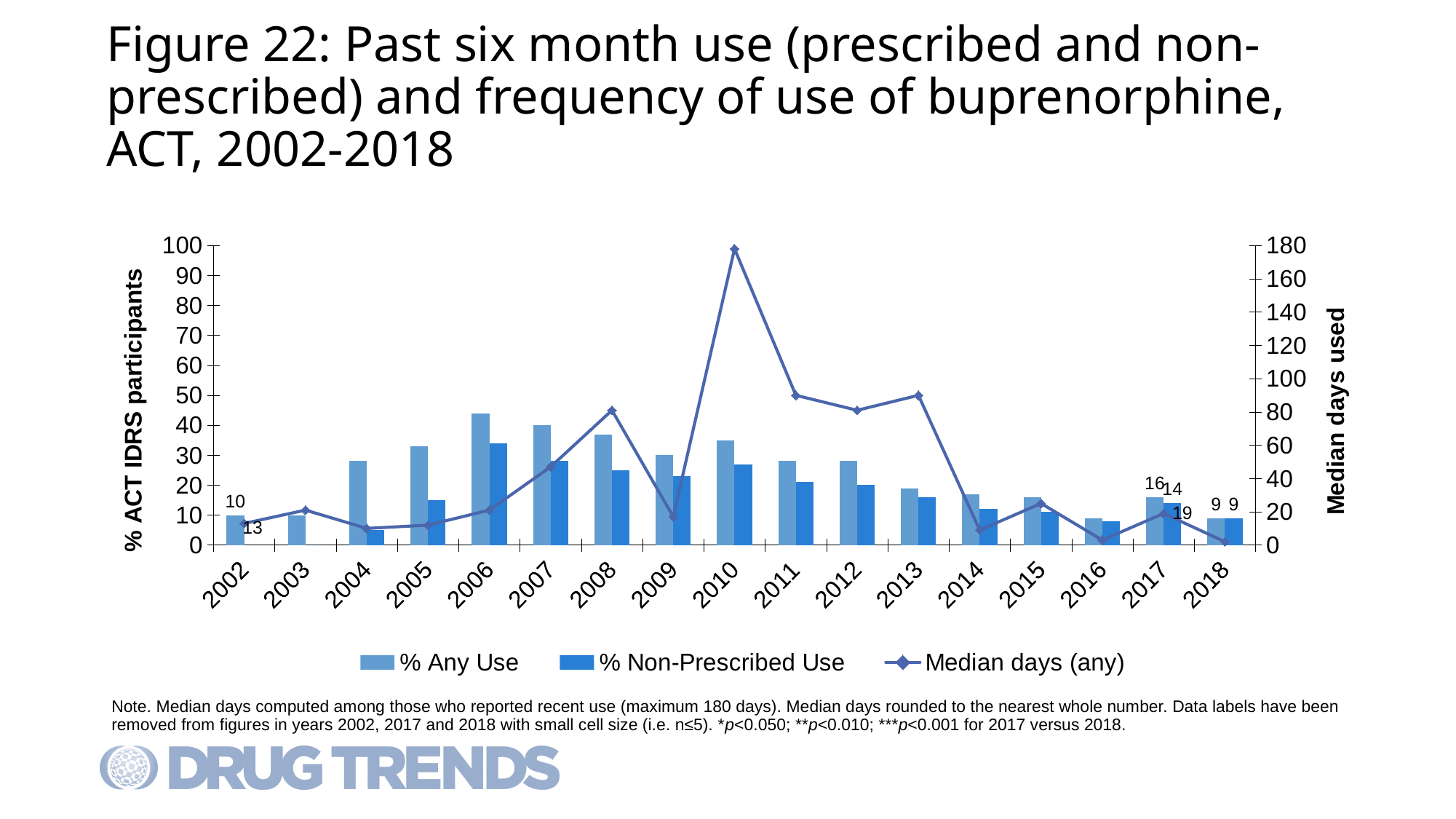
What is the difference between % Any Use and % Non-Prescribed Use in 2017? 2 Is the Median days (any) value for 2010 greater or less than 160? greater What is the % Any Use value for 2018? 9 How many series does the legend list? 3 In which year is % Any Use highest? 2006 What is the % Non-Prescribed Use value for 2017? 14 What is the % Any Use value for 2017? 16 Does Median days (any) rise or fall from 2013 to 2016? fall In which year is Median days (any) highest? 2010 What is the Median days (any) value for 2002? 13 How many years are shown on the x axis? 17 What type of chart is shown on the slide? Combined bar and line chart